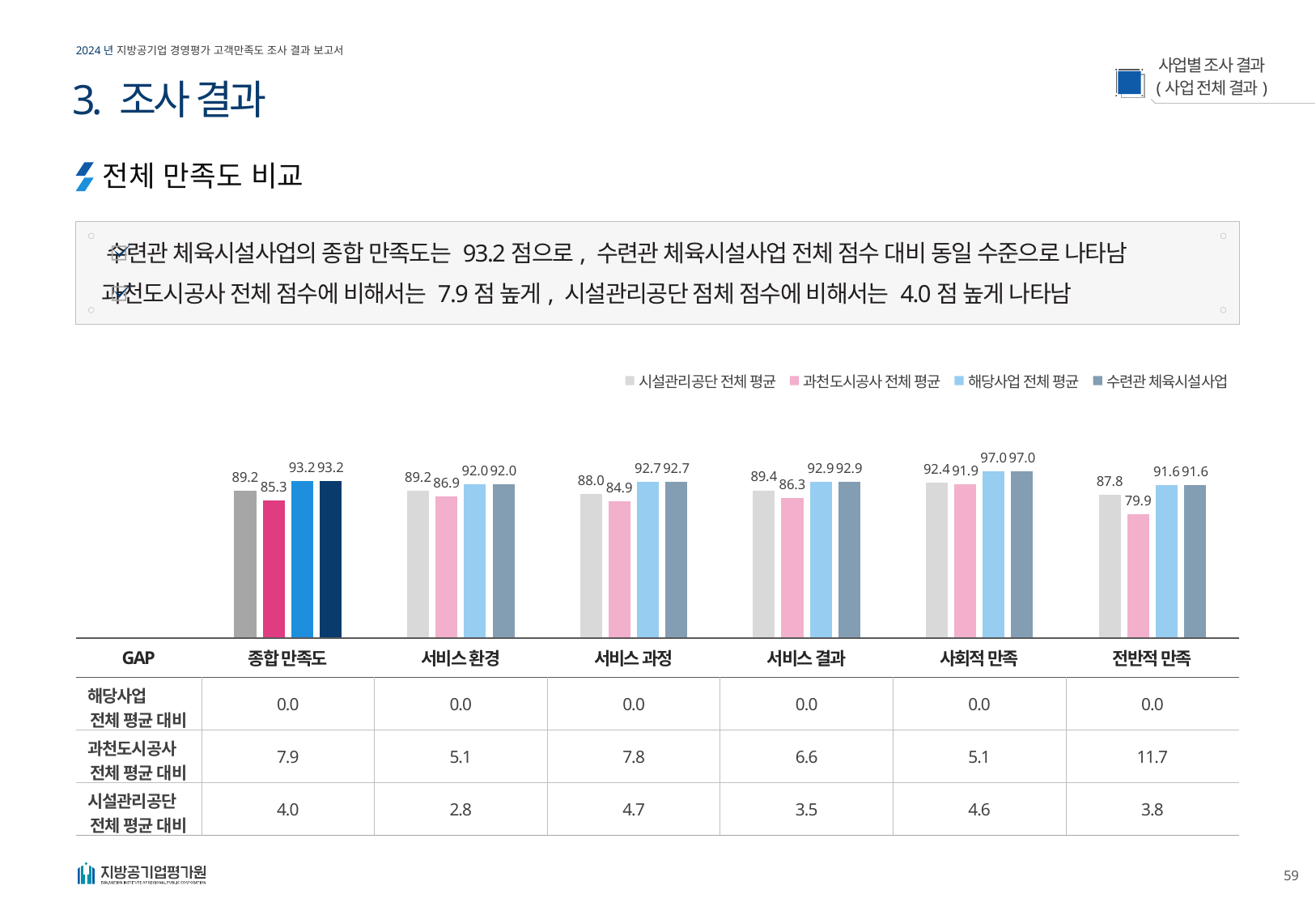
What kind of chart is shown on the slide? Bar chart What is the value of 해당사업 전체 평균 for 사회적 만족? 97.0 What is the value of 과천도시공사 전체 평균 for 전반적 만족? 79.9 How many categories are shown on the x axis of the chart? 6 What is the value of 시설관리공단 전체 평균 for 서비스 과정? 88.0 Which is larger for 서비스 환경: 시설관리공단 전체 평균 or 과천도시공사 전체 평균? 시설관리공단 전체 평균 What is the difference between 수련관 체육시설사업 and 과천도시공사 전체 평균 for 전반적 만족? 11.7 How many series does the chart legend list? 4 Which category has the lowest value for 과천도시공사 전체 평균? 전반적 만족 Which category has the highest value for 수련관 체육시설사업? 사회적 만족 What is the value of 수련관 체육시설사업 for 종합 만족도? 93.2 What is the difference between 수련관 체육시설사업 and 시설관리공단 전체 평균 for 서비스 과정? 4.7